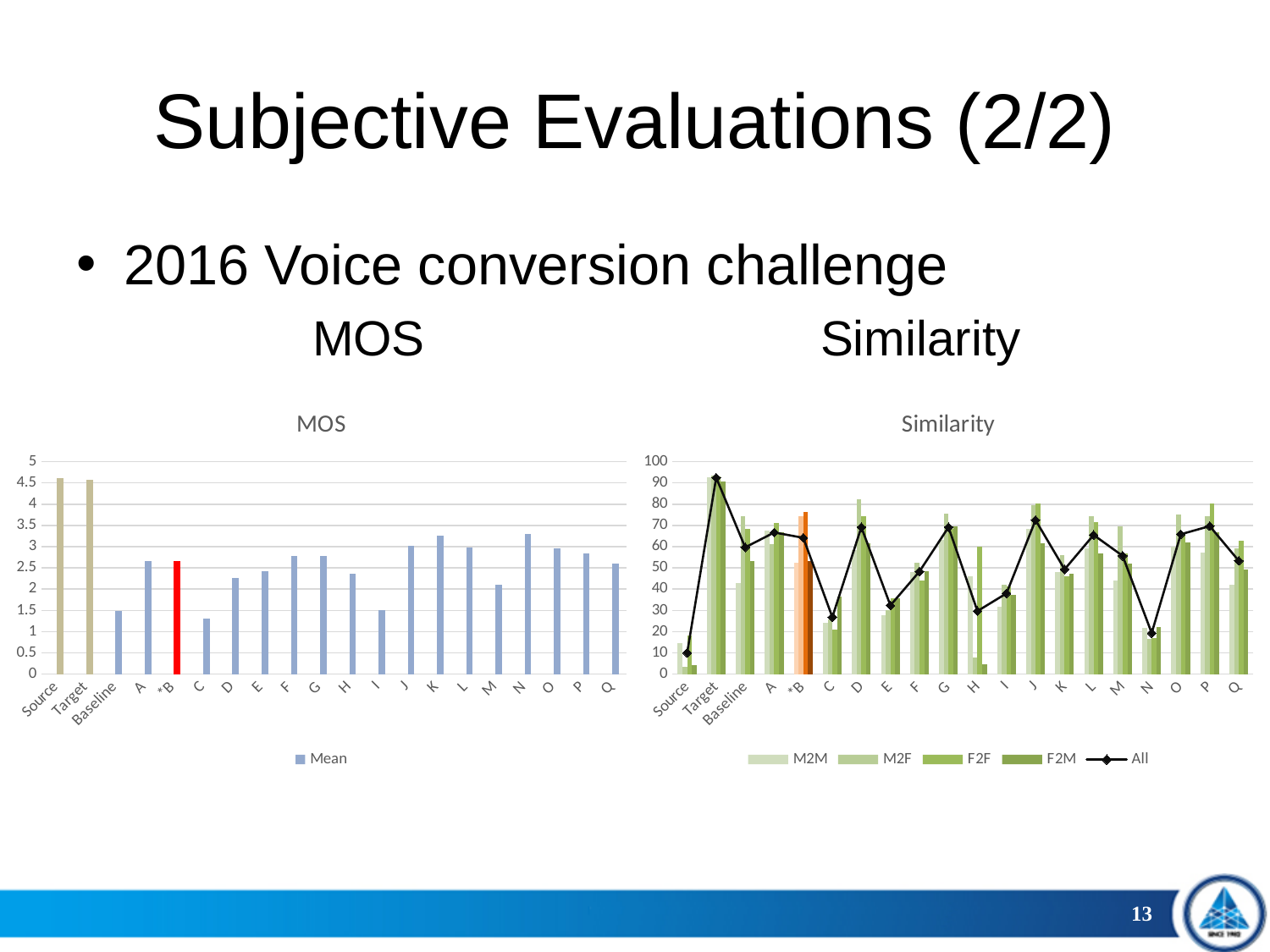
In the MOS chart, is the value for Baseline greater or less than 2? less What kind of chart is the MOS chart? bar chart In the MOS chart, which category's bar is coloured red? *B In the Similarity chart, at which category does the All line reach its highest point? Target In the MOS chart, which is larger, the value for J or the value for C? J How many series does the legend of the Similarity chart list? 5 In the Similarity chart, which is larger, the All value for D or the All value for E? D How many categories are shown on the x axis of the MOS chart? 20 How many series does the legend of the MOS chart list? 1 In the MOS chart, is the value for Source greater or less than 4? greater In the Similarity chart, at which category does the All line reach its lowest point? Source In the Similarity chart, is the All value for N greater or less than 30? less